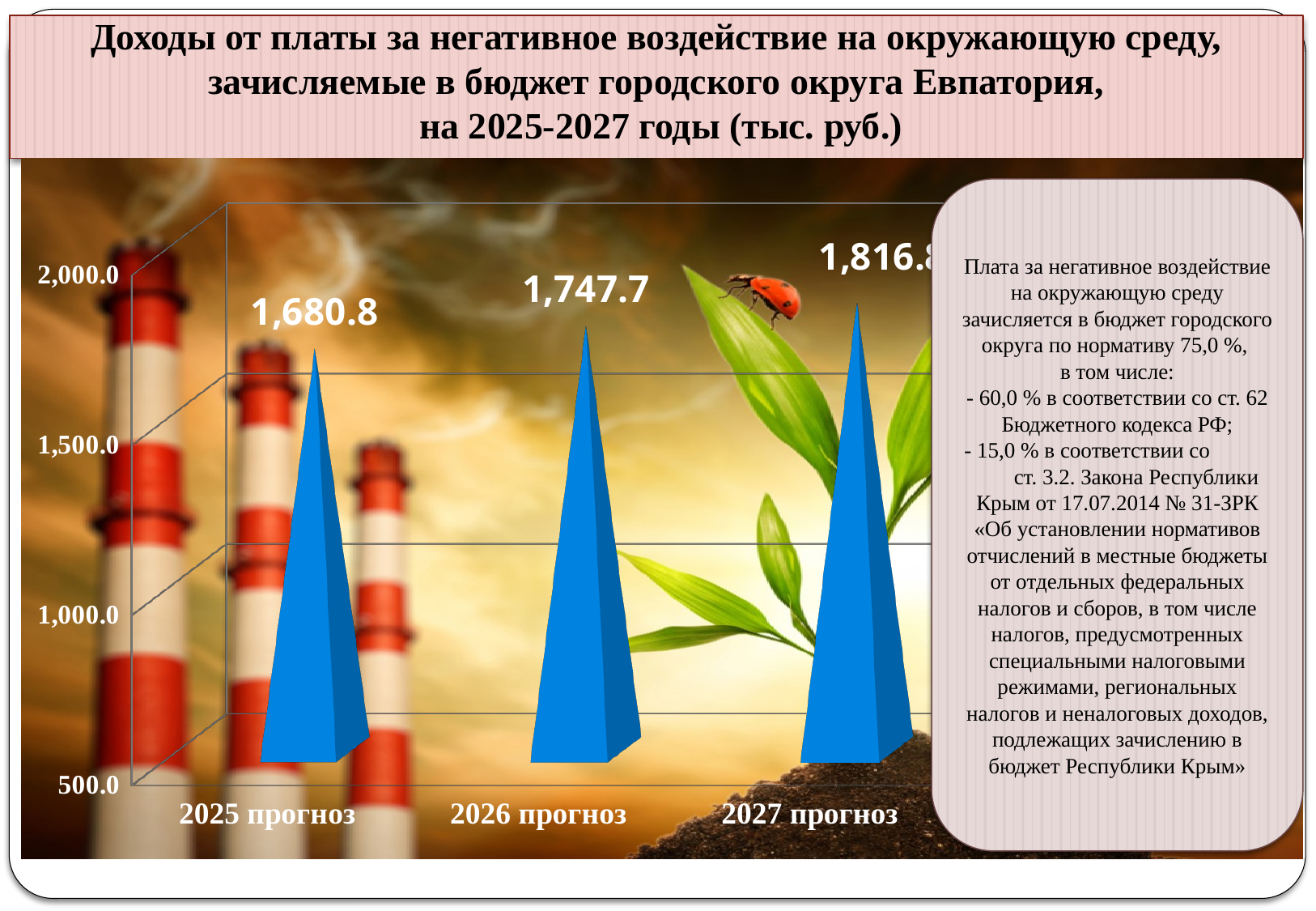
Is the value for 2027 прогноз greater or less than 1,500.0? greater How many categories are shown on the x axis? 3 Is the value for 2025 прогноз greater or less than 2,000.0? less What is the value for 2026 прогноз? 1,747.7 Which category has the lowest value? 2025 прогноз Do the values rise or fall from 2025 прогноз to 2027 прогноз? rise What kind of chart is shown on the slide? bar chart What is the difference between the values for 2026 прогноз and 2025 прогноз? 66.9 What is the value for 2025 прогноз? 1,680.8 Which category has the highest value? 2027 прогноз What unit is given in the chart title for the values? тыс. руб. Which is larger, the value for 2027 прогноз or the value for 2025 прогноз? 2027 прогноз